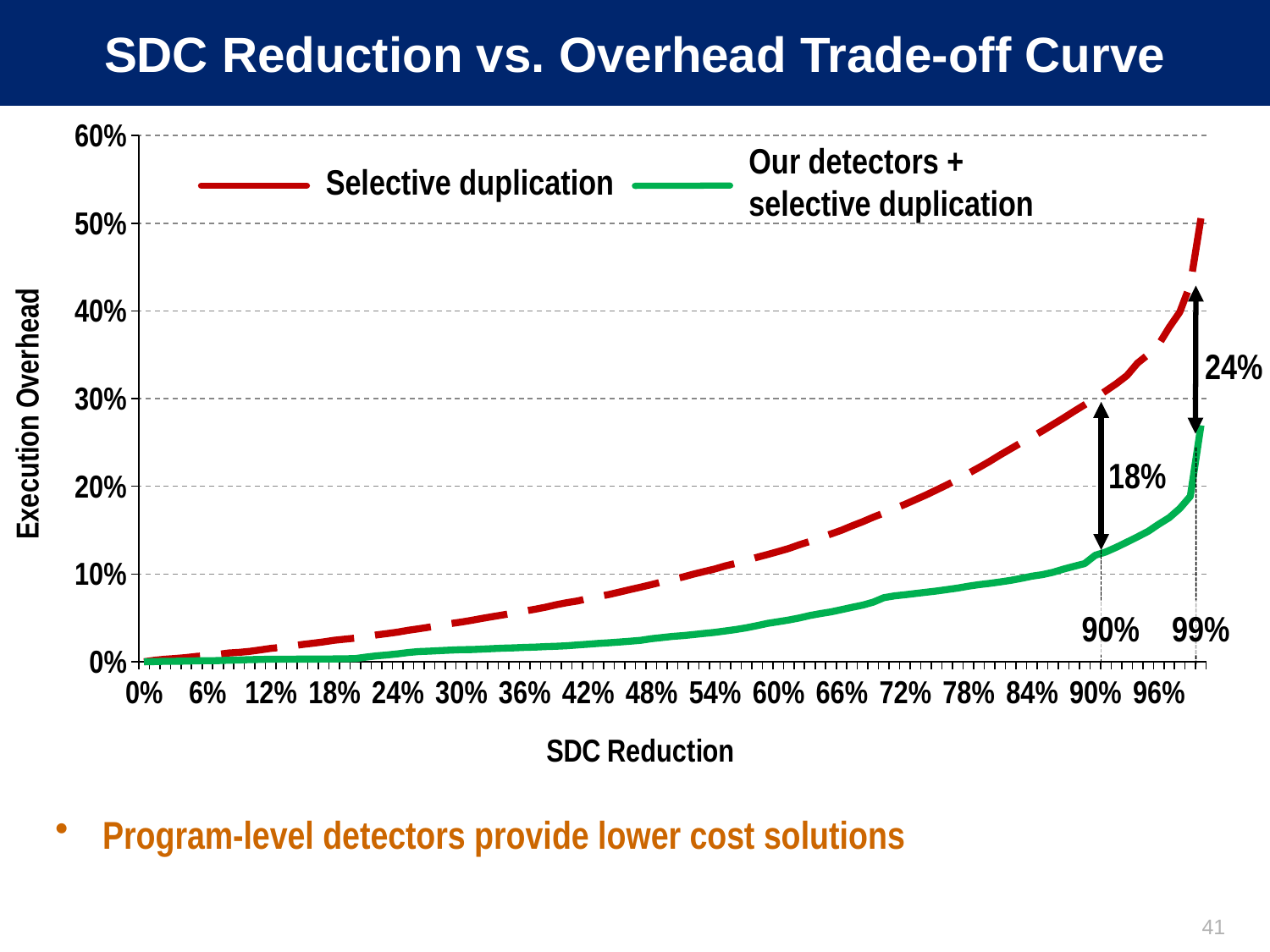
What kind of chart is shown on the slide? line chart What is the annotated gap in execution overhead between the two curves at 90% SDC reduction? 18% How many series does the legend list? 2 Does execution overhead rise or fall as SDC reduction increases along the x axis for the Selective duplication series? rise Is the execution overhead for Selective duplication at 90% SDC reduction greater or less than 20%? greater What label is on the vertical axis of the chart? Execution Overhead Which series has the higher execution overhead at 90% SDC reduction, Selective duplication or Our detectors + selective duplication? Selective duplication What is the title of the chart? SDC Reduction vs. Overhead Trade-off Curve What is the annotated gap in execution overhead between the two curves at 99% SDC reduction? 24% Is the execution overhead for Selective duplication at 60% SDC reduction greater or less than 20%? less Is the execution overhead for Our detectors + selective duplication at 90% SDC reduction greater or less than 20%? less Which series reaches the highest execution overhead on the chart? Selective duplication